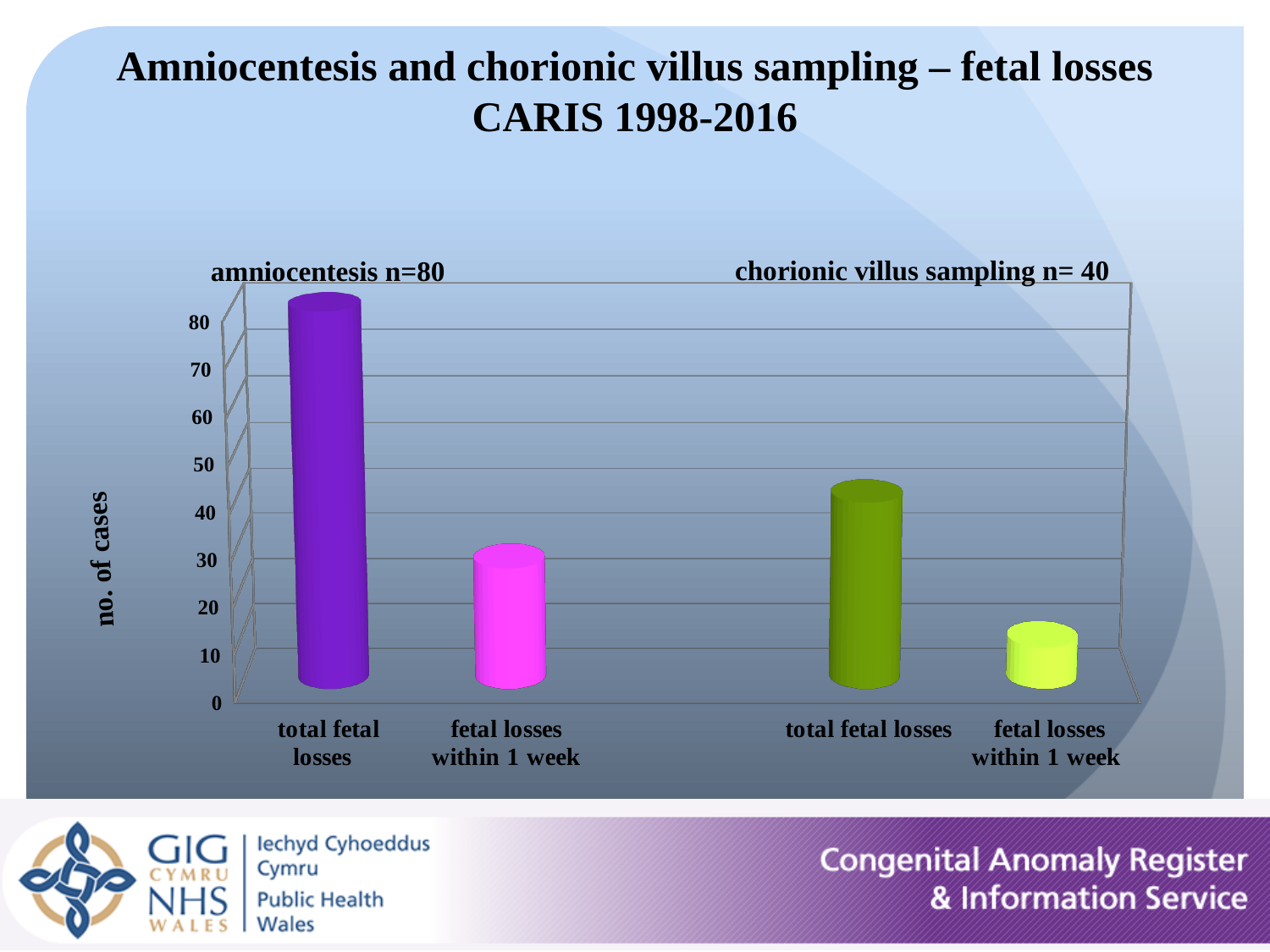
Which is larger: fetal losses within 1 week for amniocentesis or fetal losses within 1 week for chorionic villus sampling? amniocentesis Is the value for chorionic villus sampling fetal losses within 1 week greater or less than 20? less Which bar has the highest value in the chart? amniocentesis total fetal losses What is the n value printed for amniocentesis on the chart? n=80 Is the value for chorionic villus sampling total fetal losses greater or less than 30? greater Is the value for amniocentesis total fetal losses greater or less than 70? greater Which is larger: total fetal losses for amniocentesis or total fetal losses for chorionic villus sampling? amniocentesis How many bars are plotted in the chart? 4 What kind of chart is shown on the slide? bar chart Which bar has the lowest value in the chart? chorionic villus sampling fetal losses within 1 week What is the label on the vertical axis of the chart? no. of cases